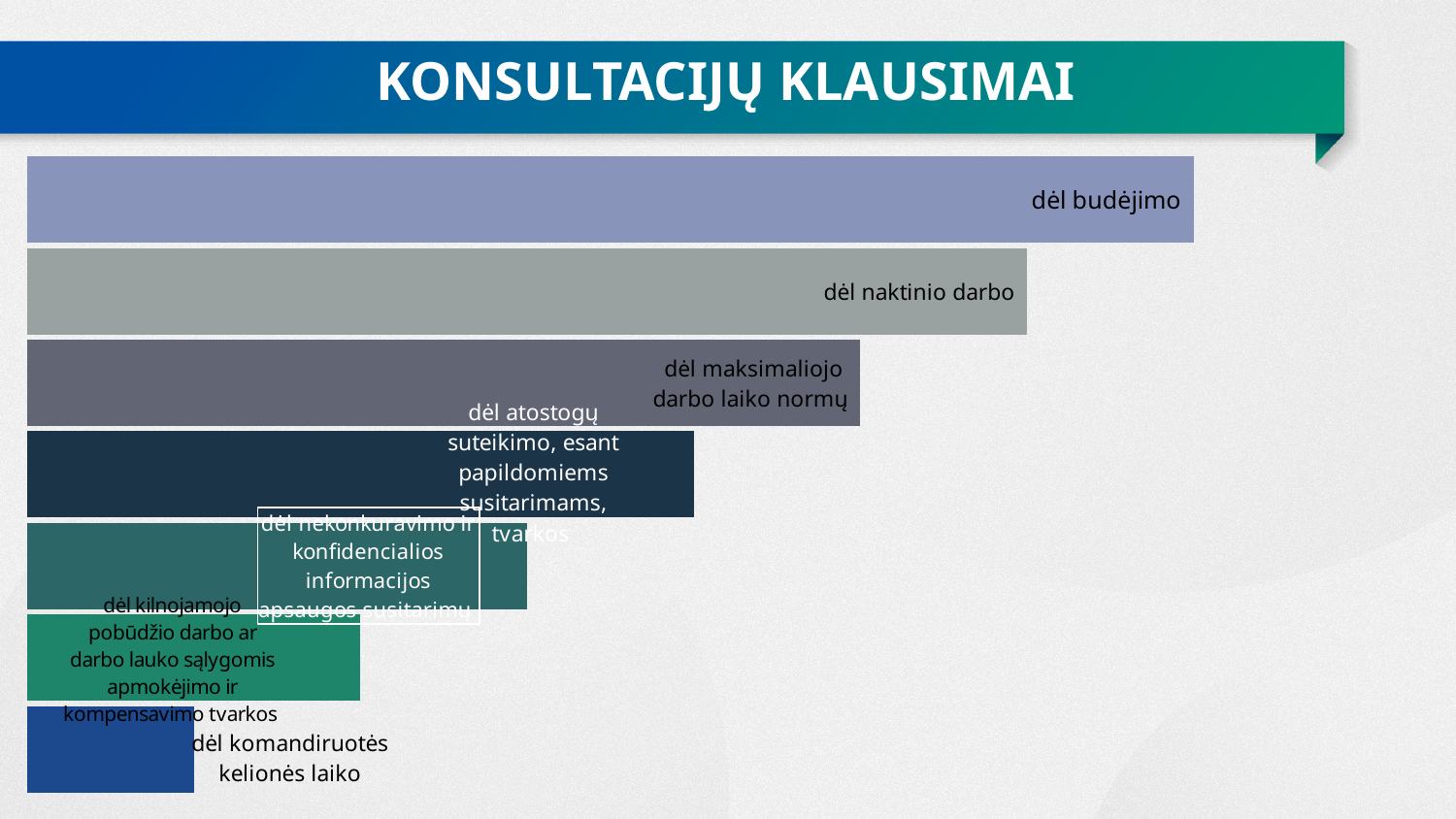
Which category has the second-longest bar in the chart? dėl naktinio darbo How many bars (categories) does the chart show? 7 Which bar is longer: "dėl maksimaliojo darbo laiko normų" or "dėl nekonkuravimo ir konfidencialios informacijos apsaugos susitarimų"? dėl maksimaliojo darbo laiko normų Are the bars in the chart oriented horizontally or vertically? horizontally Which category has the shortest bar in the chart? dėl komandiruotės kelionės laiko Which bar is longer: "dėl budėjimo" or "dėl naktinio darbo"? dėl budėjimo What is the title of the slide containing the chart? KONSULTACIJŲ KLAUSIMAI Which category has the longest bar in the chart? dėl budėjimo What kind of chart is shown on the slide? bar chart Which bar is longer: "dėl komandiruotės kelionės laiko" or "dėl kilnojamojo pobūdžio darbo ar darbo lauko sąlygomis apmokėjimo ir kompensavimo tvarkos"? dėl kilnojamojo pobūdžio darbo ar darbo lauko sąlygomis apmokėjimo ir kompensavimo tvarkos